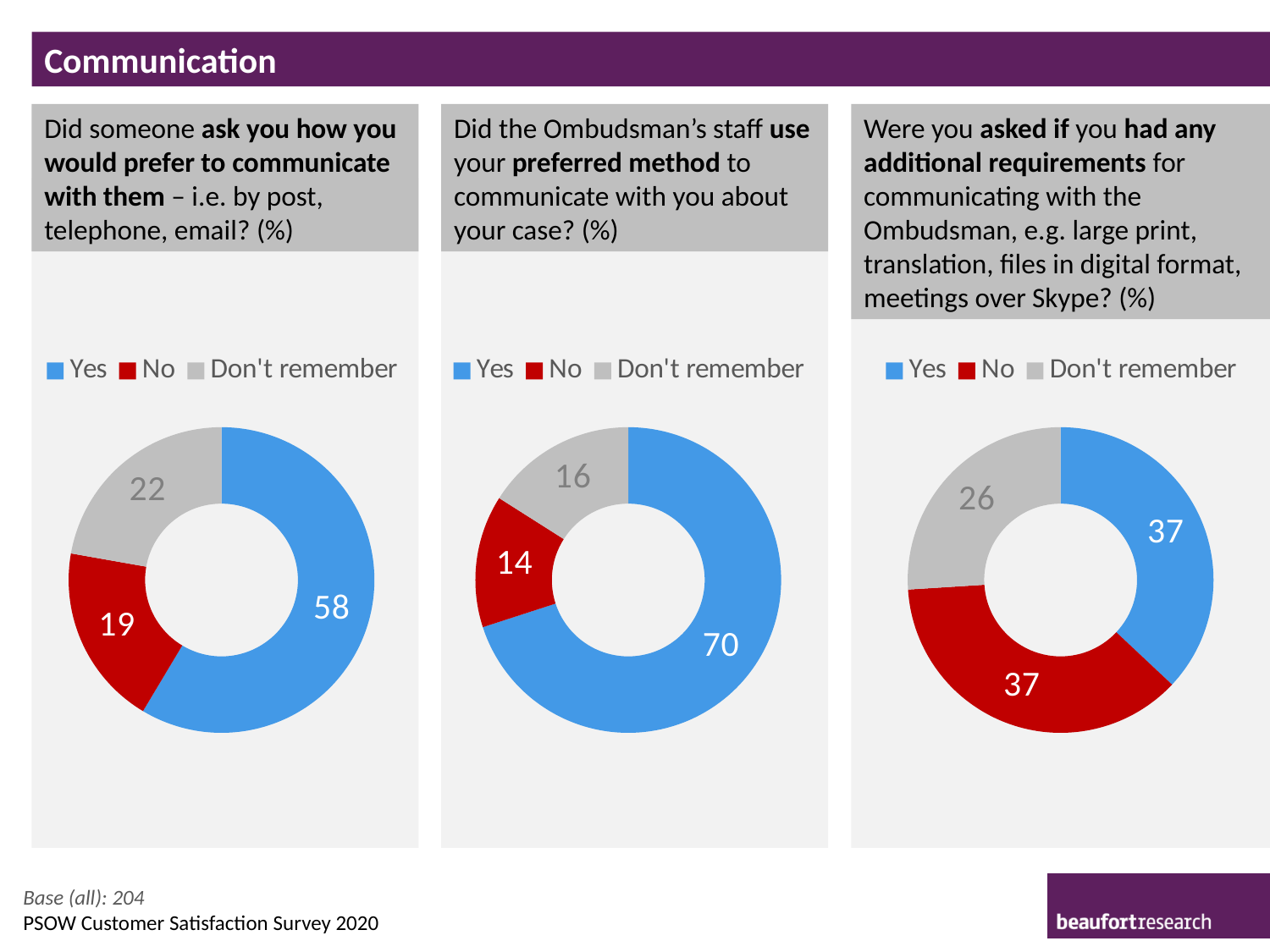
In the left chart (asked how you would prefer to communicate), which category has the lowest value? No In the left chart (asked how you would prefer to communicate), what is the difference between Yes and No? 39 In the left chart (asked how you would prefer to communicate), what is the value for Yes? 58 How many charts are shown on the slide? 3 In the right chart (asked if you had any additional requirements), what is the difference between Yes and Don't remember? 11 In the middle chart (staff used your preferred method), what is the value for No? 14 In the left chart (asked how you would prefer to communicate), what is the value for Don't remember? 22 In the right chart (asked if you had any additional requirements), what is the value for Don't remember? 26 What kind of chart is used in the right chart (asked if you had any additional requirements)? Doughnut chart In the middle chart (staff used your preferred method), which category has the highest value? Yes How many entries does the legend of the middle chart list? 3 In the middle chart (staff used your preferred method), which is larger, No or Don't remember? Don't remember